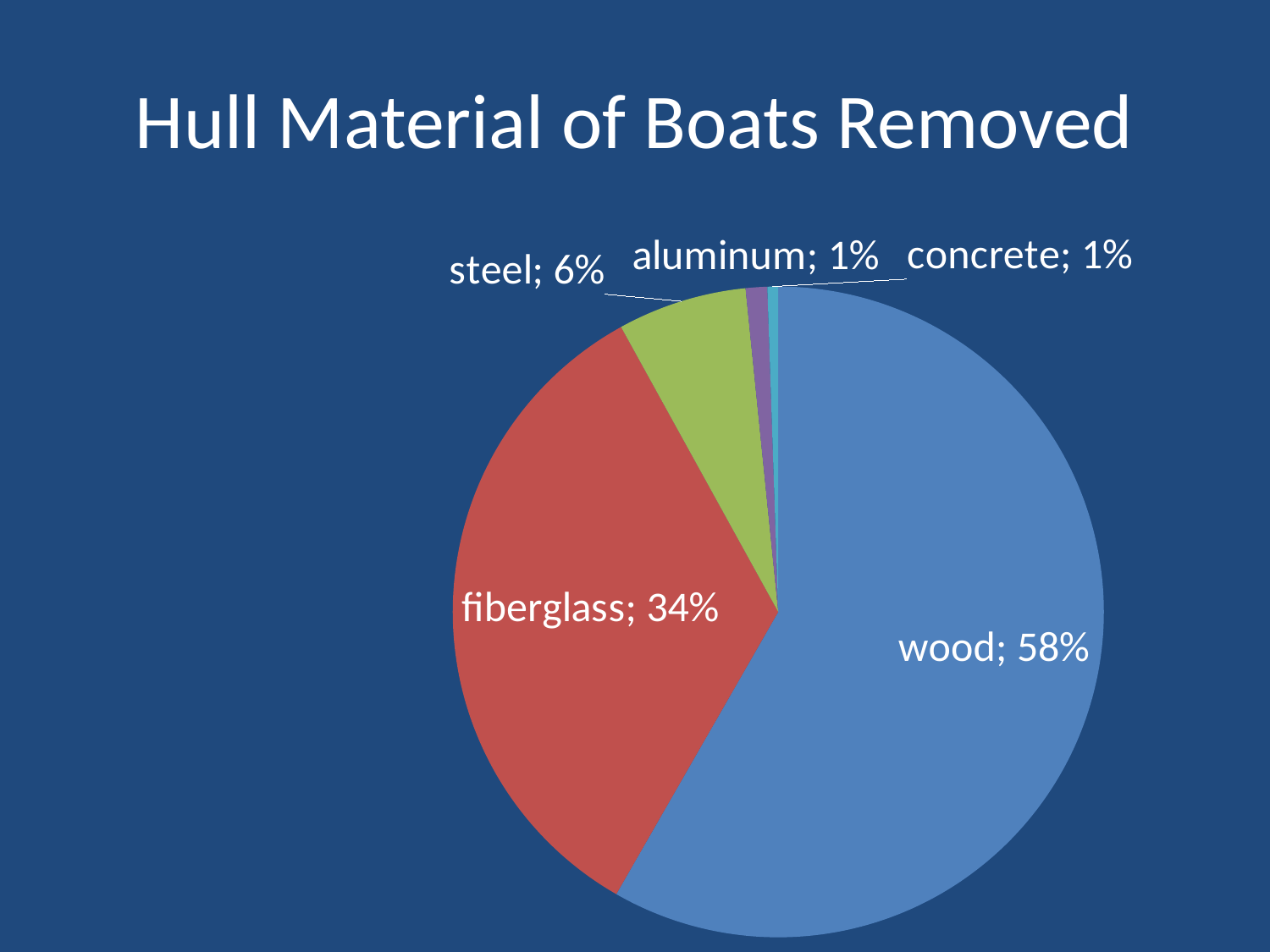
What share of boats removed had a wood hull? 58% Which is larger, the share for fiberglass or the share for steel? fiberglass What is the title of the chart? Hull Material of Boats Removed What is the difference in share between wood and fiberglass hulls? 24% What kind of chart is shown on the slide? pie chart What is the difference in share between fiberglass and steel hulls? 28% What share of boats removed had an aluminum hull? 1% What colour is the fiberglass slice of the pie chart? red Which hull material accounts for the largest share of boats removed? wood What share of boats removed had a steel hull? 6% How many hull material categories are shown in the pie chart? 5 What share of boats removed had a fiberglass hull? 34%